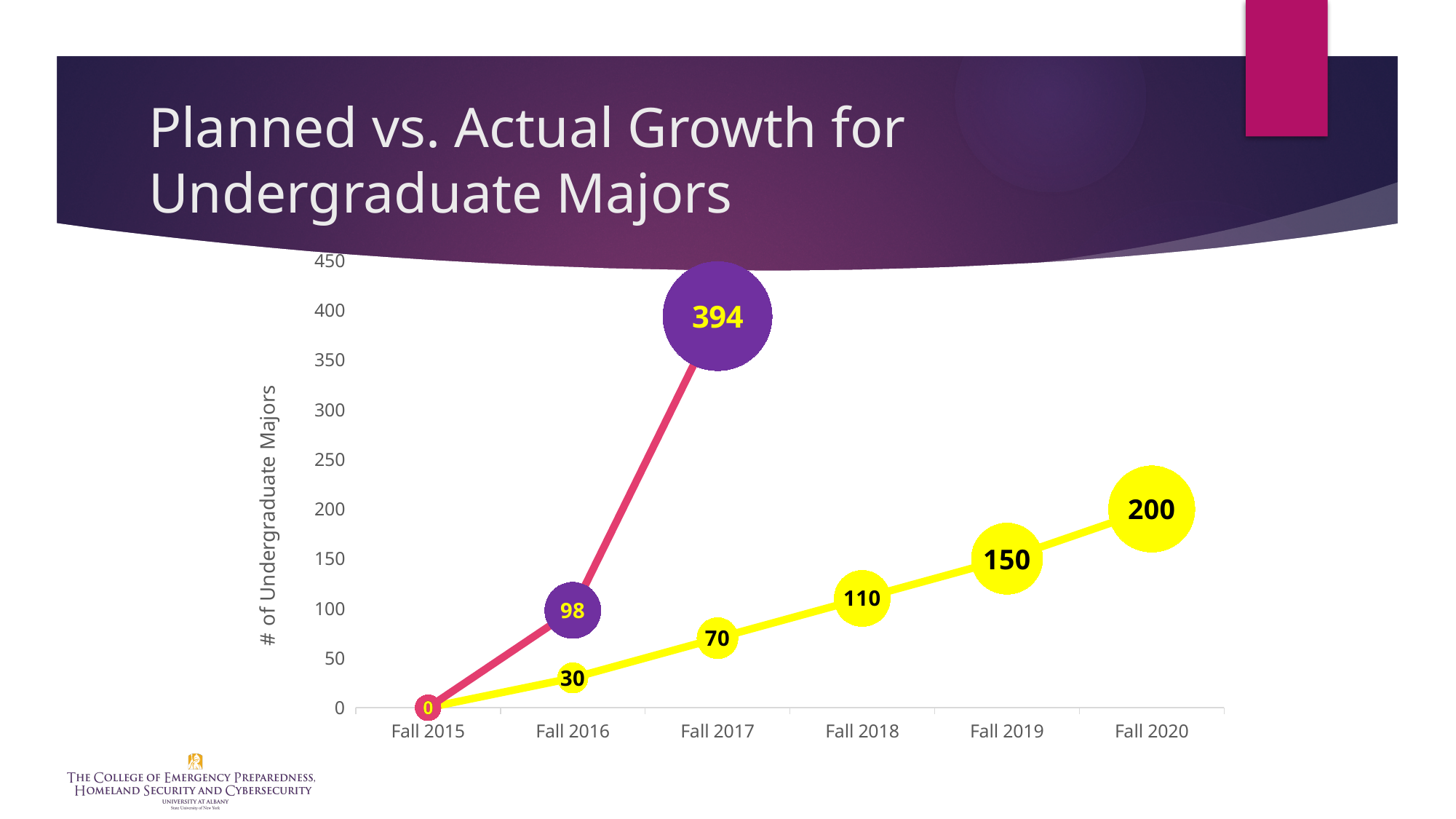
At Fall 2016, which is larger: the purple marker value or the yellow line value? The purple marker value (98) What is the value of the yellow line at Fall 2018? 110 How many x-axis categories are shown on the chart? 6 What is the value of the purple marker at Fall 2017? 394 What is the value of the yellow line at Fall 2020? 200 What is the y-axis title of the chart? # of Undergraduate Majors What is the difference between the purple marker value and the yellow line value at Fall 2017? 324 What is the difference between the yellow line values at Fall 2019 and Fall 2018? 40 At which x-axis category does the yellow line reach its highest value? Fall 2020 What is the value of the yellow line at Fall 2016? 30 Does the yellow line rise or fall from Fall 2015 to Fall 2020? Rise What is the value of the purple marker at Fall 2016? 98